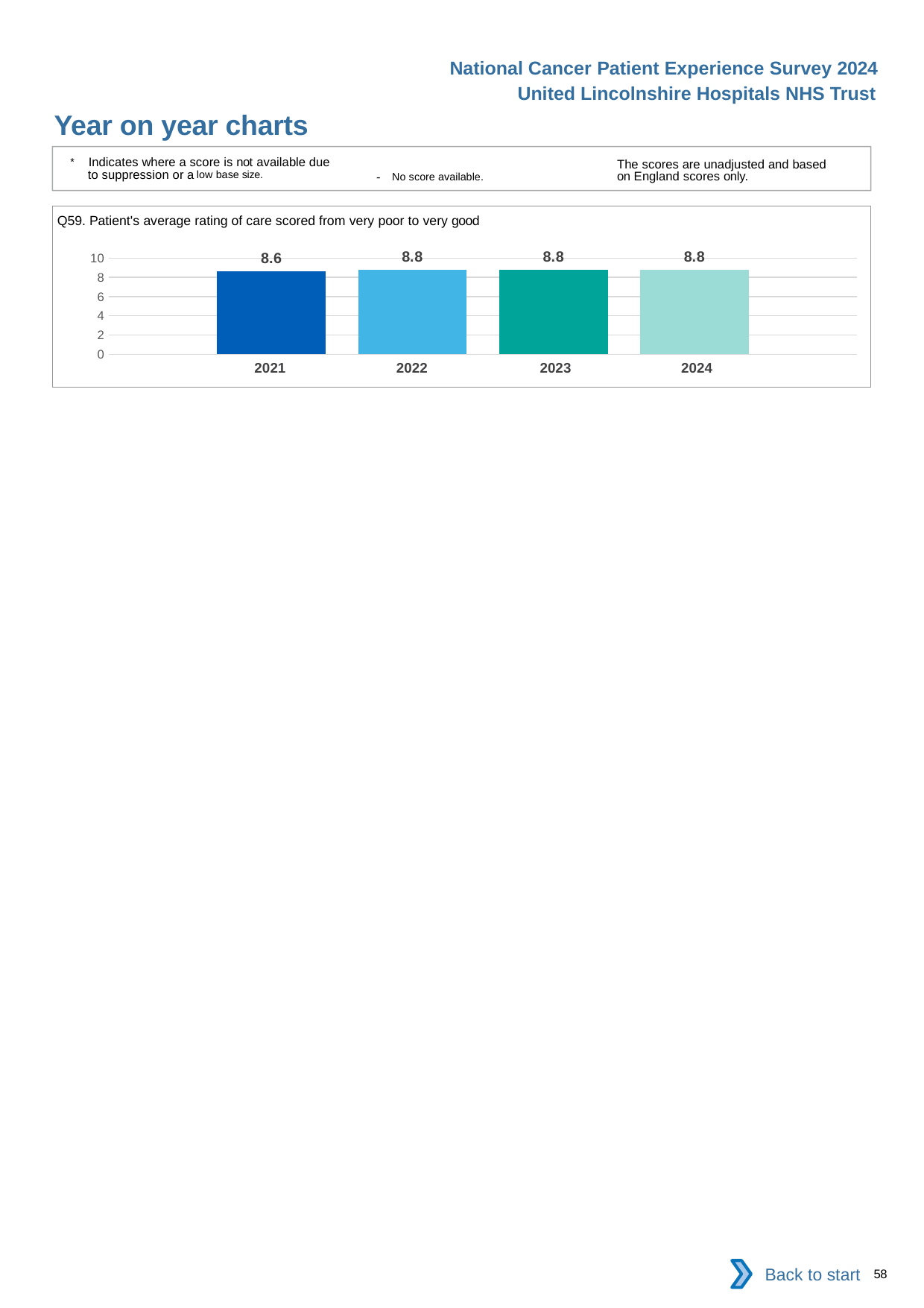
What is the title of the chart? Q59. Patient's average rating of care scored from very poor to very good What is the difference between the values for 2022 and 2021? 0.2 What is the value for 2022? 8.8 What is the highest value shown on the vertical axis? 10 What is the value for 2024? 8.8 What kind of chart is shown? bar chart Is the value for 2021 greater or less than 8? greater Which is larger, the value for 2021 or the value for 2023? 2023 Do the values rise or fall from 2021 to 2022? rise What is the value for 2021? 8.6 Which year has the lowest value? 2021 How many years are shown on the chart? 4